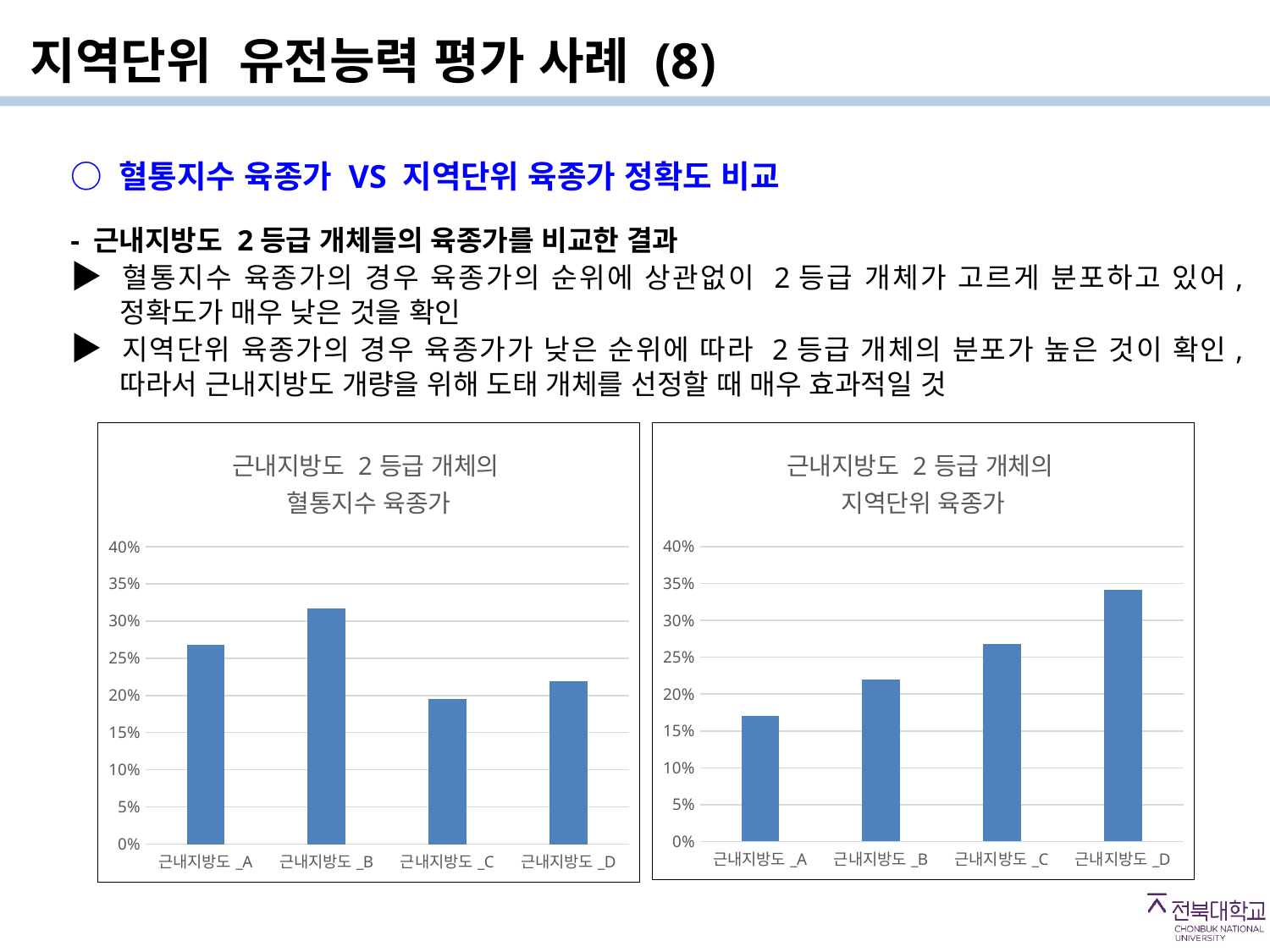
What kind of chart is the left chart (혈통지수 육종가)? bar chart In the left chart (혈통지수 육종가), is the value for 근내지방도 _B greater or less than 30%? greater In the right chart (지역단위 육종가), is the value for 근내지방도 _D greater or less than 30%? greater In the left chart (혈통지수 육종가), which category has the lowest value? 근내지방도 _C In the right chart (지역단위 육종가), do the values rise or fall from 근내지방도 _A to 근내지방도 _D? rise In the right chart (지역단위 육종가), which category has the lowest value? 근내지방도 _A In the right chart (지역단위 육종가), which category has the highest value? 근내지방도 _D In the left chart (혈통지수 육종가), which is larger, the value for 근내지방도 _A or 근내지방도 _D? 근내지방도 _A In the right chart (지역단위 육종가), is the value for 근내지방도 _A greater or less than 20%? less In the left chart (혈통지수 육종가), which category has the highest value? 근내지방도 _B How many categories are shown in the right chart (지역단위 육종가)? 4